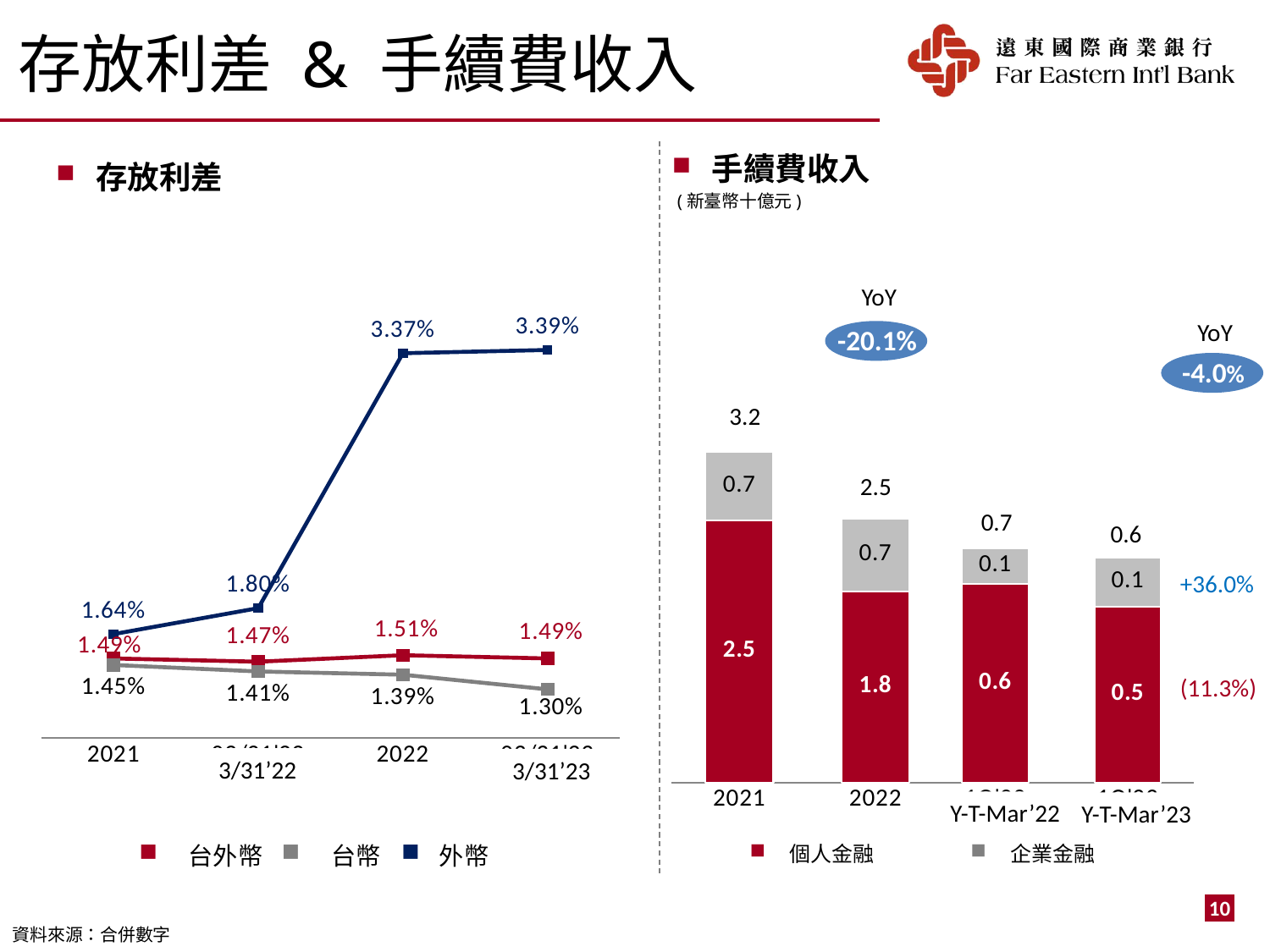
How many series does the legend of the 存放利差 chart list? 3 In the 存放利差 chart, what is the difference between the 外幣 value in 2022 and at 3/31'22? 1.57% In the 手續費收入 chart, what is the total of the stacked bar for 2021? 3.2 In the 存放利差 chart, what is the value for 台幣 in 2022? 1.39% In the 存放利差 chart, does the 台幣 series rise or fall from 2021 to 3/31'23? fall In the 手續費收入 chart, what is the difference between the 個人金融 values for 2021 and 2022? 0.7 What kind of chart is the 存放利差 chart? line chart In the 存放利差 chart, which series has the highest value at 3/31'23? 外幣 In the 手續費收入 chart, which period has the lowest total? Y-T-Mar'23 In the 存放利差 chart, what is the value for 外幣 at 3/31'23? 3.39% In the 存放利差 chart, what is the value for 台外幣 at 3/31'22? 1.47% In the 手續費收入 chart, what is the 個人金融 value for 2022? 1.8